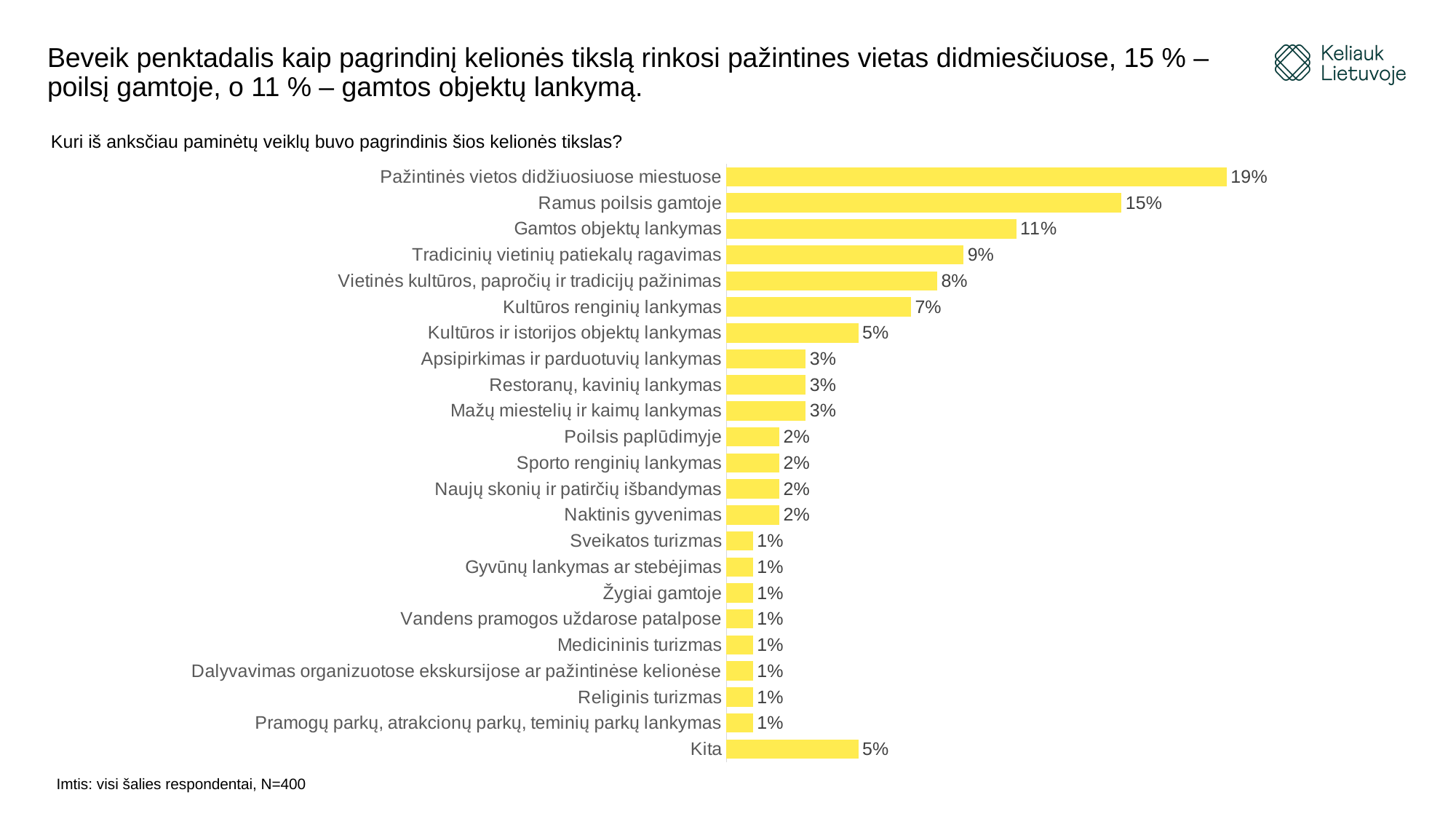
What is the value for "Kita"? 5% What is the value for "Poilsis paplūdimyje"? 2% What is the value for "Ramus poilsis gamtoje"? 15% Which category has the highest value? Pažintinės vietos didžiuosiuose miestuose What is the value for "Kultūros renginių lankymas"? 7% What is the difference between the values for "Tradicinių vietinių patiekalų ragavimas" and "Kultūros ir istorijos objektų lankymas"? 4% What is the difference between the values for "Pažintinės vietos didžiuosiuose miestuose" and "Gamtos objektų lankymas"? 8% How many categories are shown in the chart? 23 What kind of chart is shown on the slide? Bar chart What colour are the bars in the chart? Yellow What is the value for "Sveikatos turizmas"? 1% Which is larger: the value for "Vietinės kultūros, papročių ir tradicijų pažinimas" or the value for "Kita"? Vietinės kultūros, papročių ir tradicijų pažinimas